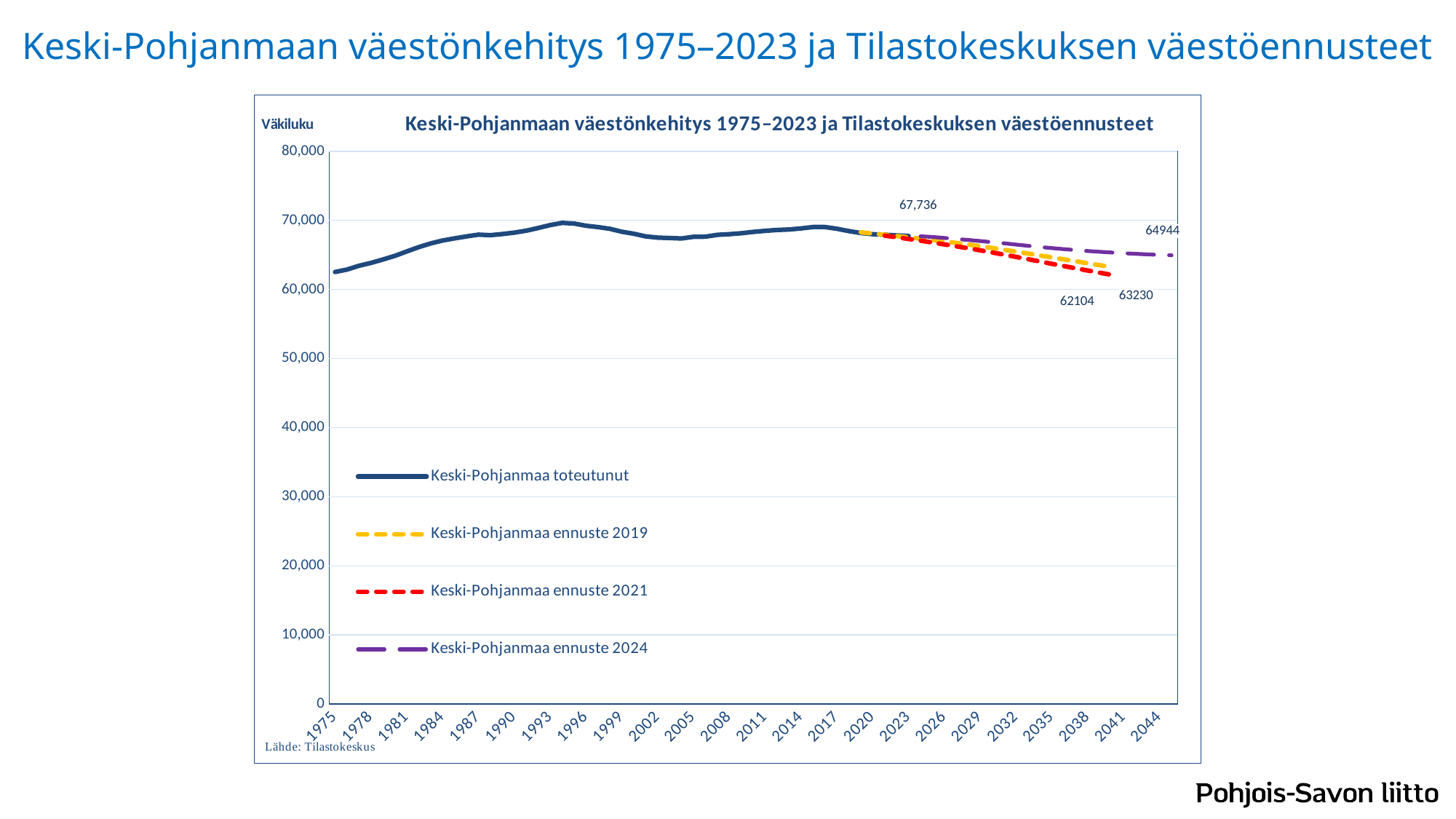
Does the Keski-Pohjanmaa toteutunut line rise or fall between 1975 and 1993? rise What kind of chart is shown on the slide? line chart What value is labelled at the end of the Keski-Pohjanmaa ennuste 2024 line? 64944 Is the value of the Keski-Pohjanmaa toteutunut line in 1975 greater or less than 60,000? greater What value is labelled at the end of the Keski-Pohjanmaa toteutunut line? 67,736 Which forecast series ends at the lowest labelled value? Keski-Pohjanmaa ennuste 2021 What is the difference between the labelled end values of the ennuste 2024 line (64944) and the ennuste 2021 line (62104)? 2840 What value is labelled at the end of the Keski-Pohjanmaa ennuste 2019 line? 63230 What is the label on the vertical axis of the chart? Väkiluku What value is labelled at the end of the Keski-Pohjanmaa ennuste 2021 line? 62104 Which forecast series ends at the highest labelled value? Keski-Pohjanmaa ennuste 2024 How many series does the legend list? 4